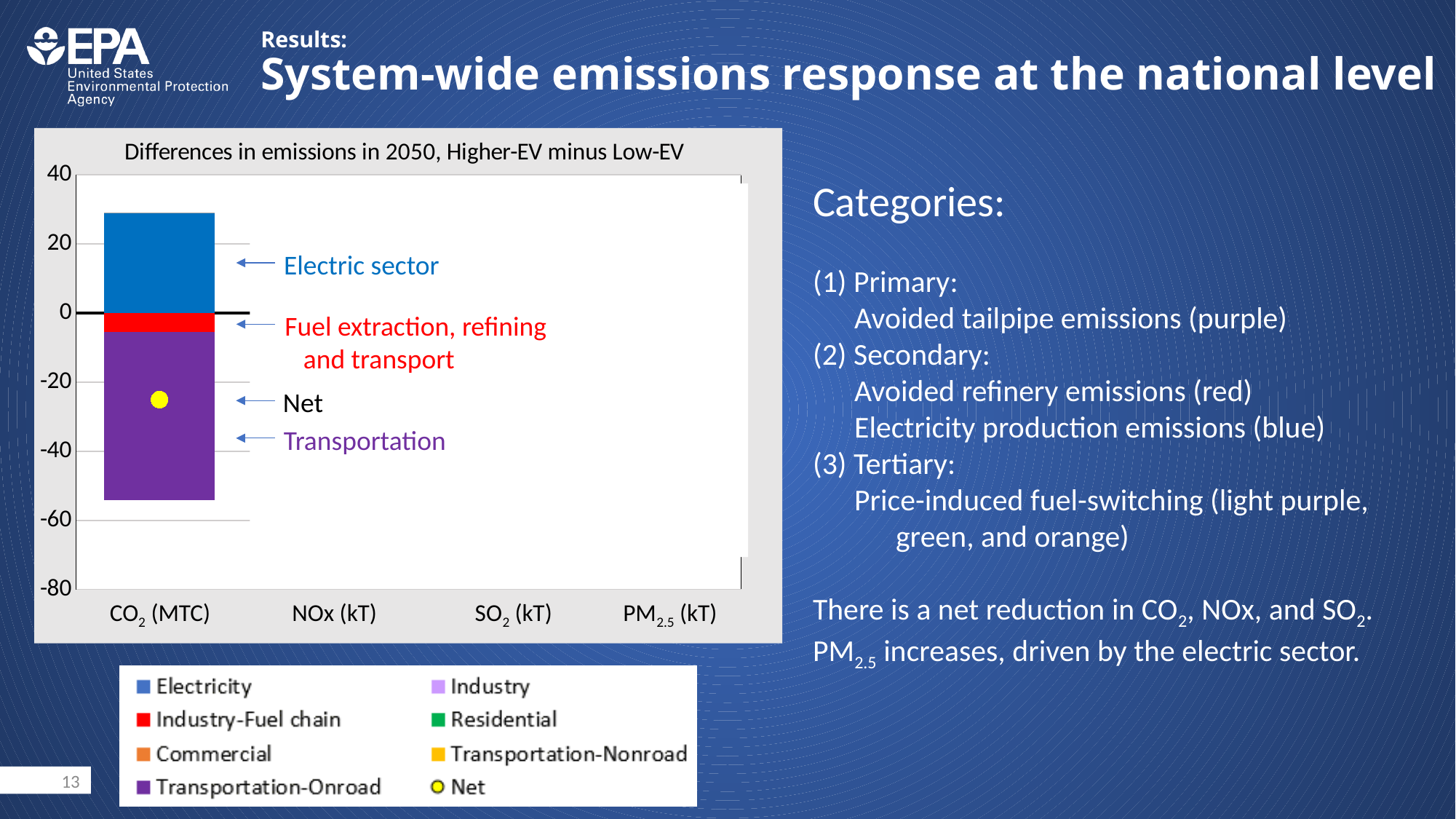
Which x-axis category has a bar plotted in the chart? CO2 (MTC) How many categories are labelled on the x axis of the chart? 4 Does the bottom of the Transportation-Onroad segment for CO2 (MTC) lie above or below -40? below What kind of chart is shown on the slide? bar chart Is the Net value for CO2 (MTC) greater or less than -20? less Which segment of the CO2 (MTC) bar is the largest in size? Transportation-Onroad Which legend entry is shown in purple? Transportation-Onroad What is the title of the chart? Differences in emissions in 2050, Higher-EV minus Low-EV Which segment of the CO2 (MTC) bar is larger in size, Electricity or Industry-Fuel chain? Electricity Is the Electricity segment for CO2 (MTC) greater or less than 20? greater How many entries does the chart legend list? 8